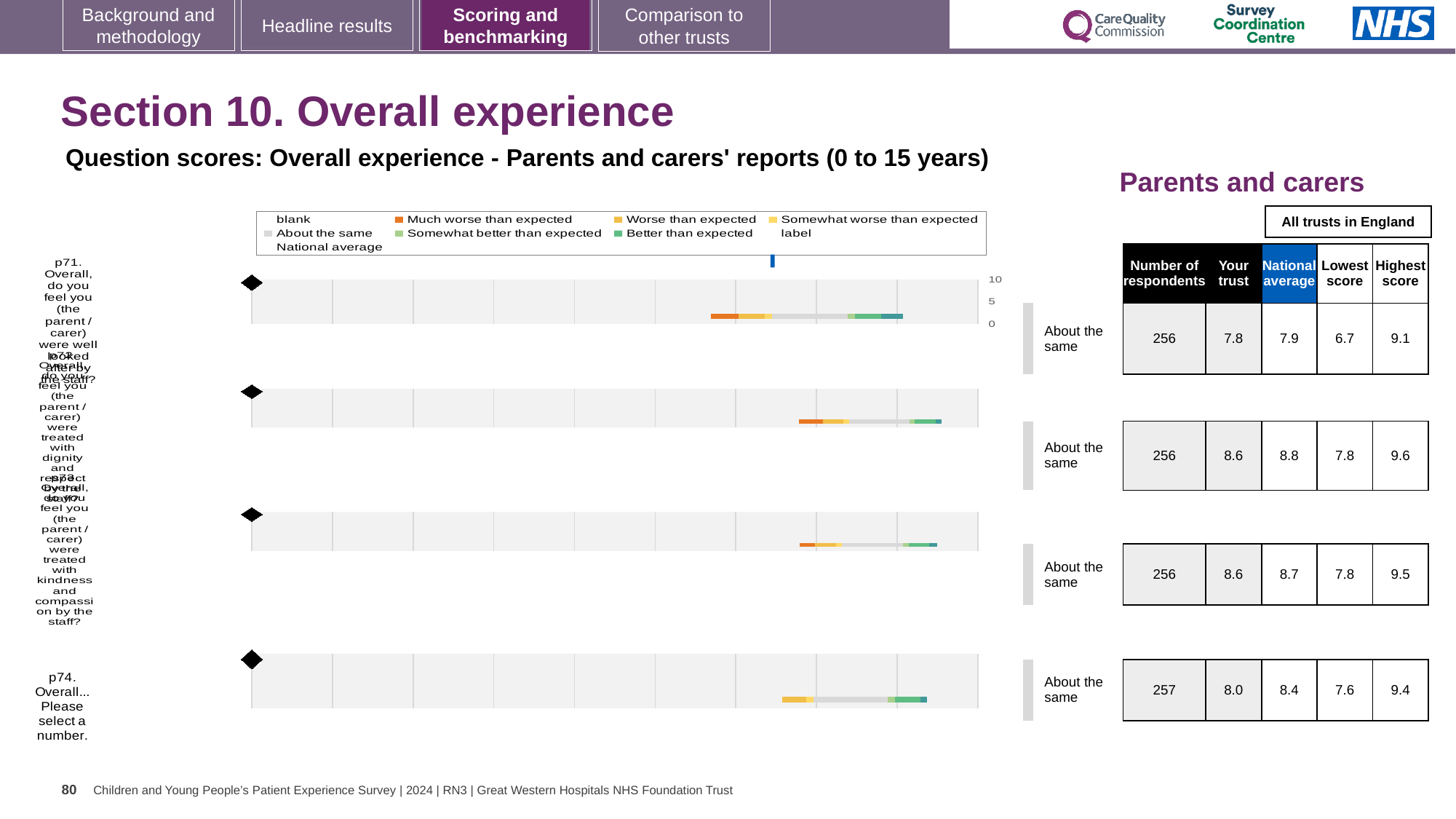
For p74, what is the difference between the national average and the 'Your trust' score? 0.4 What is the 'Your trust' score for p71 (Overall, do you feel you were well looked after by the staff?)? 7.8 What is the national average score for p74 (Overall... Please select a number)? 8.4 How many entries does the chart legend list? 9 What is the number of respondents for p74? 257 For p72, which is larger: the 'Your trust' score or the national average? National average What kind of chart is shown on the slide? bar chart Which question has the lowest 'Your trust' score? p71 What is the highest score across all trusts in England for p72 (treated with dignity and respect)? 9.6 How many questions (rows) are plotted in the chart? 4 Which question has the lowest 'Lowest score' value? p71 What benchmark category is shown for all four questions? About the same